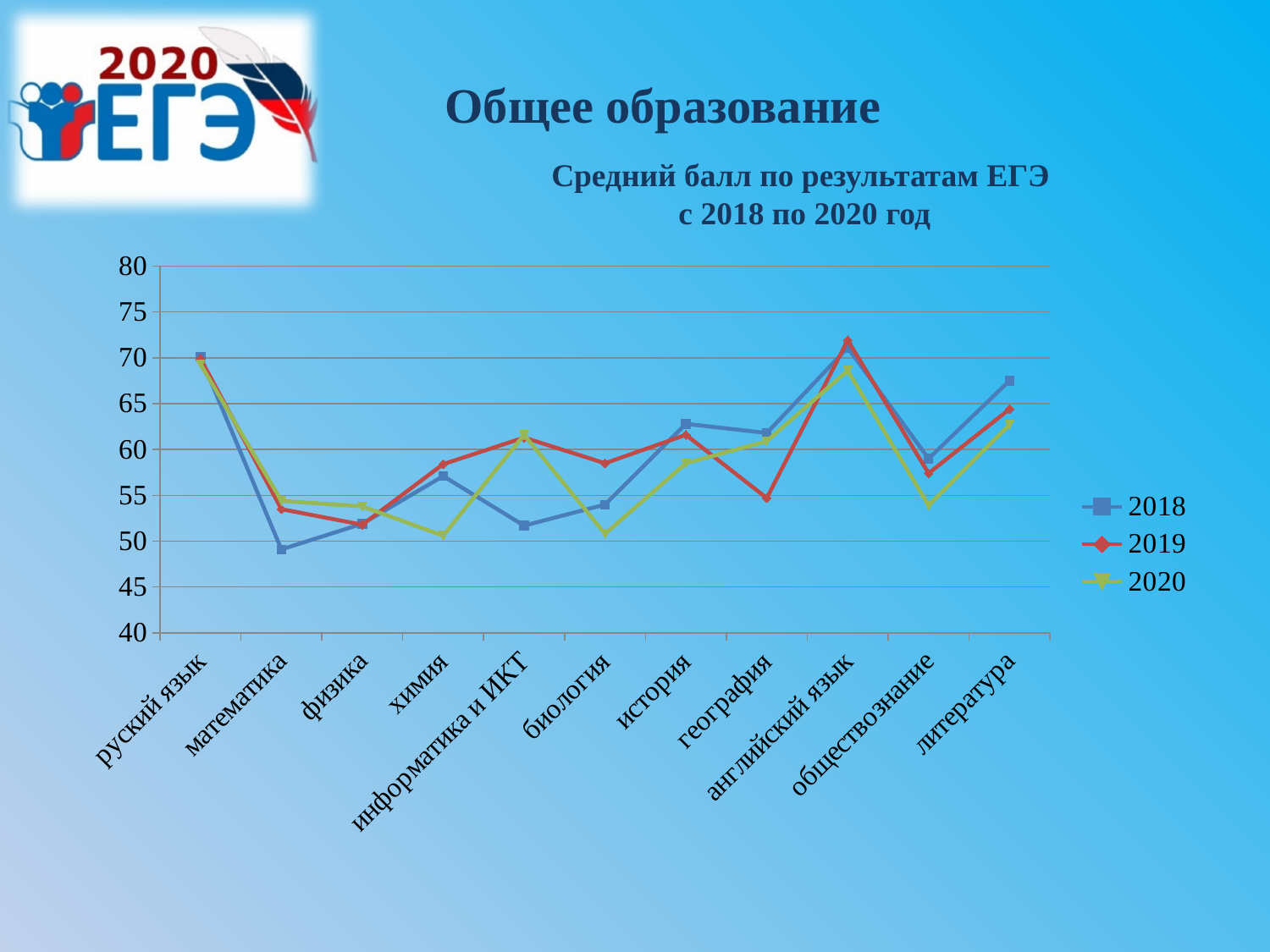
Which subject has the highest value for the 2019 series? английский язык Is the 2018 value for литература greater or less than 65? greater How many subjects are shown along the x axis? 11 Which subject has the lowest value for the 2018 series? математика What kind of chart is shown on the slide? line chart Is the 2018 value for математика greater or less than 50? less For математика, which series has the larger value, 2018 or 2020? 2020 For география, which series has the larger value, 2018 or 2019? 2018 What is the title of the chart? Средний балл по результатам ЕГЭ с 2018 по 2020 год How many series does the legend list? 3 Is the 2019 value for английский язык greater or less than 70? greater